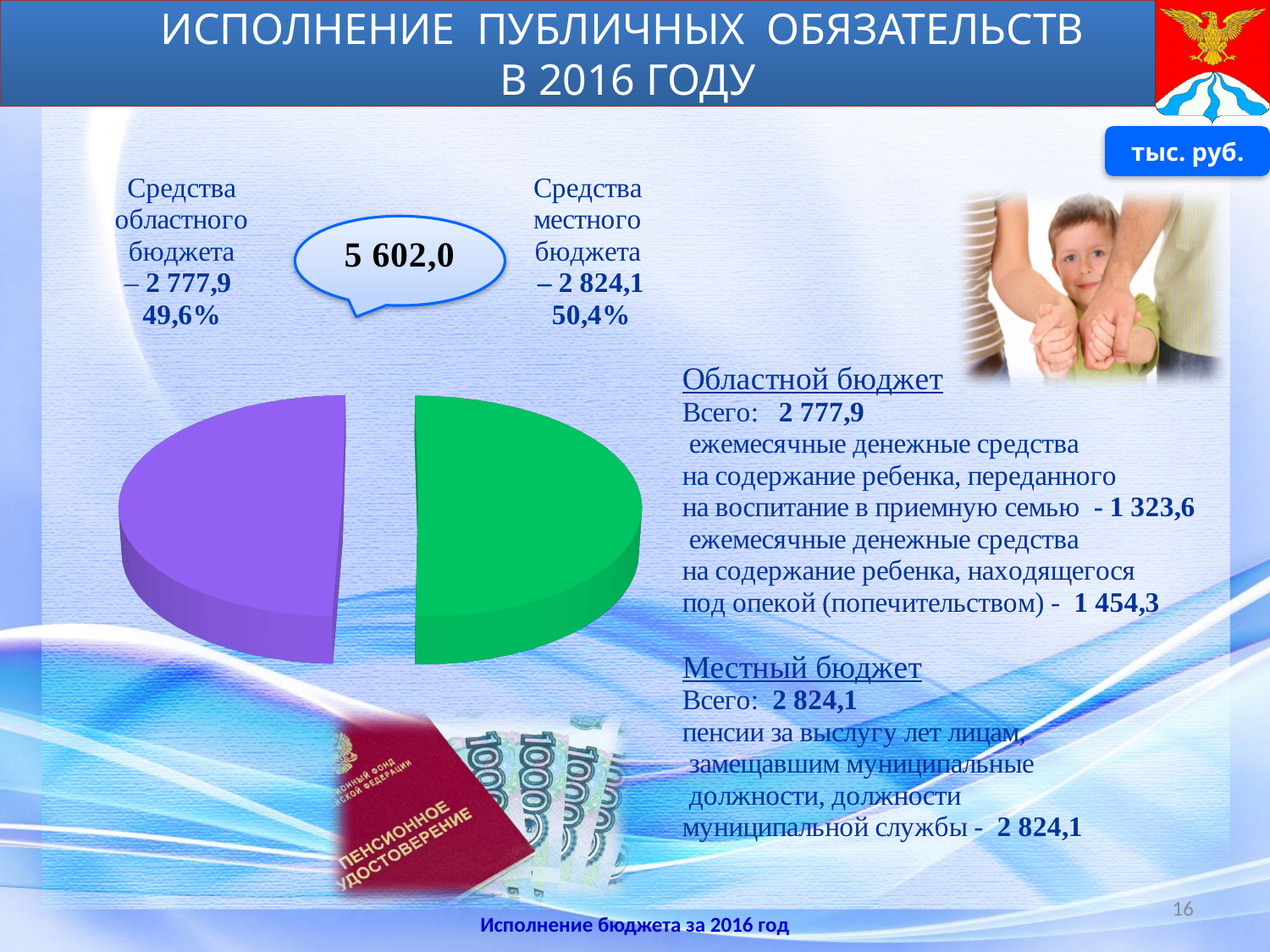
What is the value for Средства областного бюджета? 2 777,9 What is the value for Средства местного бюджета? 2 824,1 What is the total of the two slices in the pie chart? 5 602,0 What share of the pie does Средства местного бюджета represent? 50,4% Which is larger, Средства областного бюджета or Средства местного бюджета? Средства местного бюджета What unit is indicated for the values on the slide? тыс. руб. What share of the pie does Средства областного бюджета represent? 49,6% What is the difference between Средства местного бюджета and Средства областного бюджета? 46,2 What two colours are used for the slices of the pie chart? purple and green How many slices does the pie chart have? 2 What kind of chart is shown on the slide? pie chart Which category has the smallest slice in the pie chart? Средства областного бюджета